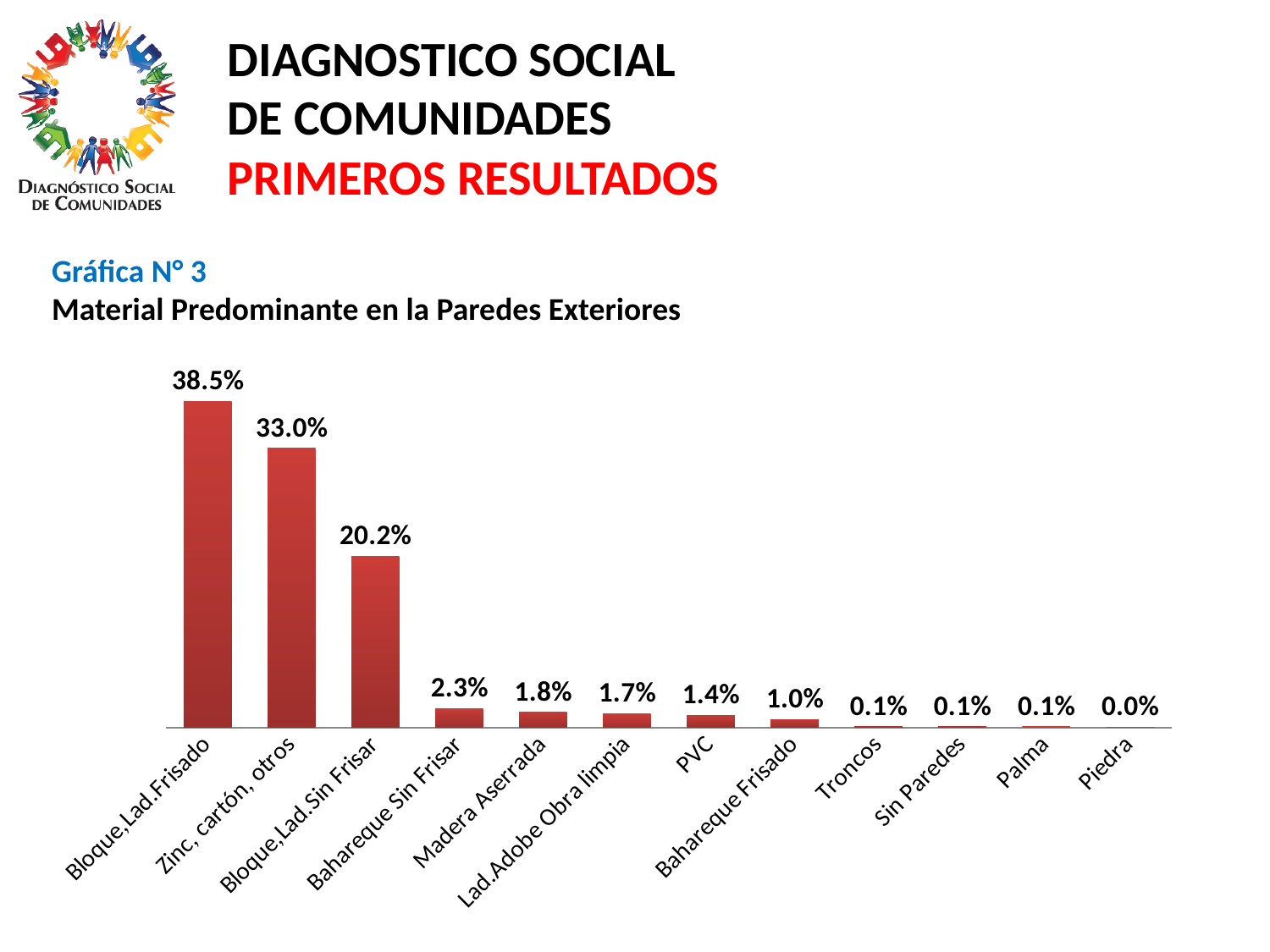
What is the title of the chart? Material Predominante en la Paredes Exteriores What is the value for PVC? 1.4% What kind of chart is this? Bar chart What is the value for Zinc, cartón, otros? 33.0% What is the difference between Bloque, Lad.Frisado and Zinc, cartón, otros? 5.5% What is the value for Bloque, Lad.Frisado? 38.5% Which is larger, Madera Aserrada or Bahareque Frisado? Madera Aserrada What is the difference between Bloque, Lad.Sin Frisar and Bahareque Sin Frisar? 17.9% Which category has the lowest value? Piedra Which category has the highest value? Bloque, Lad.Frisado What is the value for Bahareque Sin Frisar? 2.3% How many categories are shown in the chart? 12